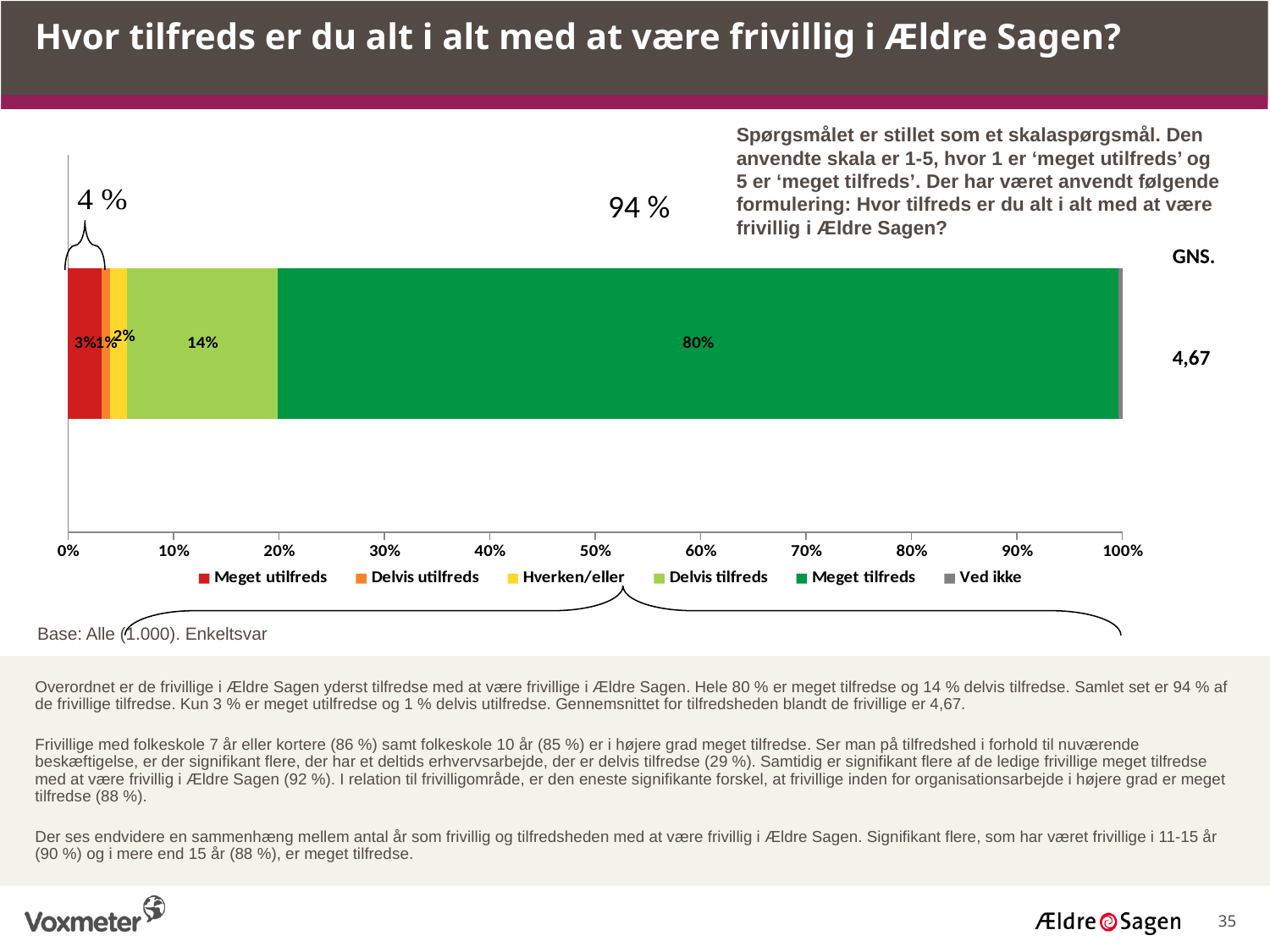
What percentage of respondents answered 'Meget utilfreds'? 3% Is the value for 'Meget tilfreds' greater or less than 70%? greater What kind of chart is shown on the slide? Stacked bar chart Which response category has the largest share in the bar? Meget tilfreds What is the difference in percentage points between 'Meget tilfreds' and 'Delvis tilfreds'? 66 How many series does the legend list? 6 Which is larger, the share for 'Meget utilfreds' or the share for 'Hverken/eller'? Meget utilfreds What percentage of respondents answered 'Meget tilfreds'? 80% What percentage of respondents answered 'Delvis tilfreds'? 14% What percentage of respondents answered 'Hverken/eller'? 2% What percentage of respondents answered 'Delvis utilfreds'? 1% What average score (GNS.) is shown next to the bar? 4,67